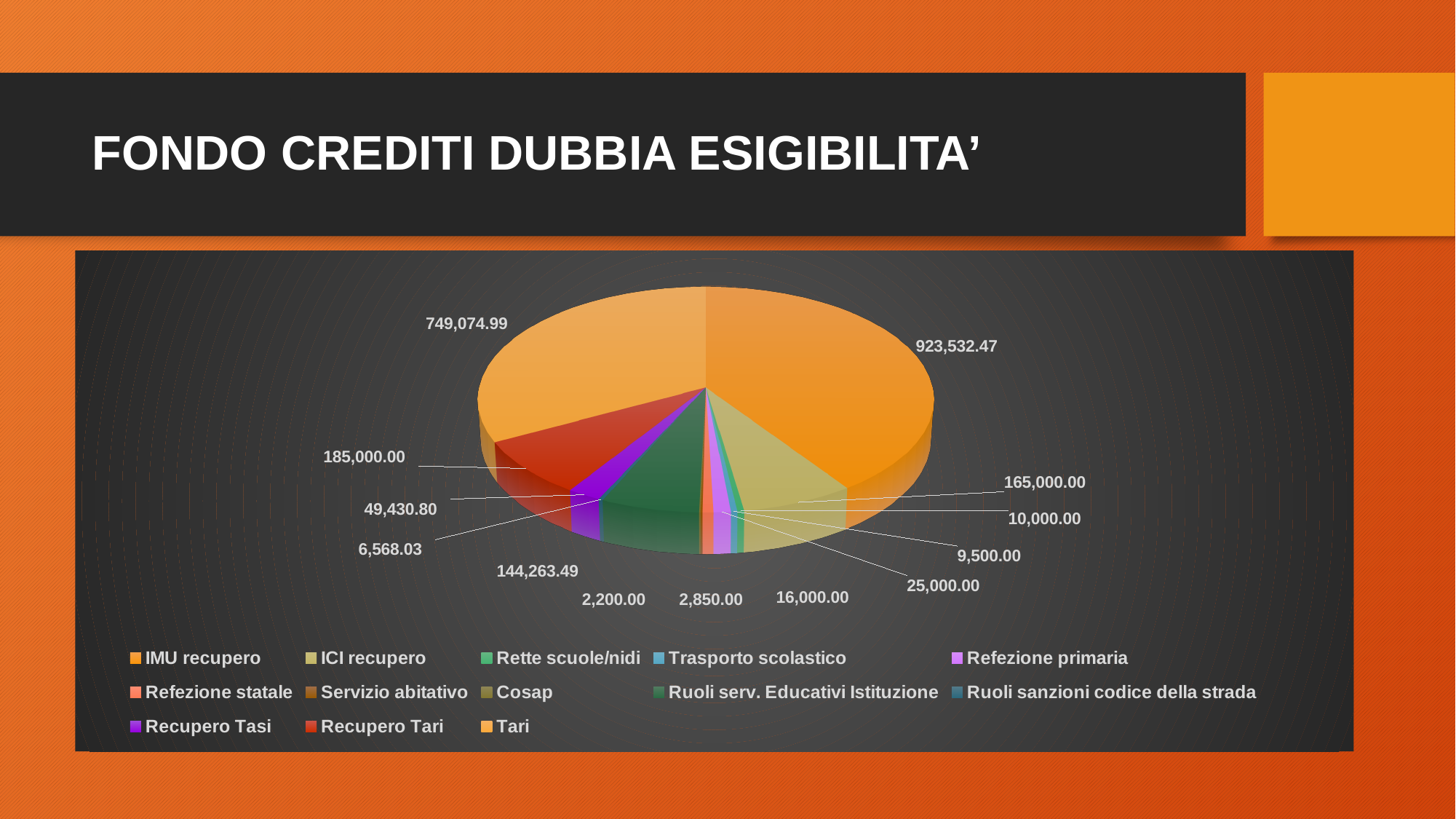
What is the title of the slide containing the pie chart? FONDO CREDITI DUBBIA ESIGIBILITA' What is the value shown for IMU recupero? 923,532.47 What is the value shown for Ruoli serv. Educativi Istituzione? 144,263.49 What is the value shown for Recupero Tasi? 49,430.80 Which category has the largest slice of the pie? IMU recupero What is the value shown for Tari? 749,074.99 What is the smallest value labelled on the pie chart? 2,200.00 What kind of chart is shown on the slide? pie chart What is the value shown for Recupero Tari? 185,000.00 What is the difference between the values for IMU recupero and Tari? 174,457.48 What is the value shown for ICI recupero? 165,000.00 How many categories does the legend of the pie chart list? 13